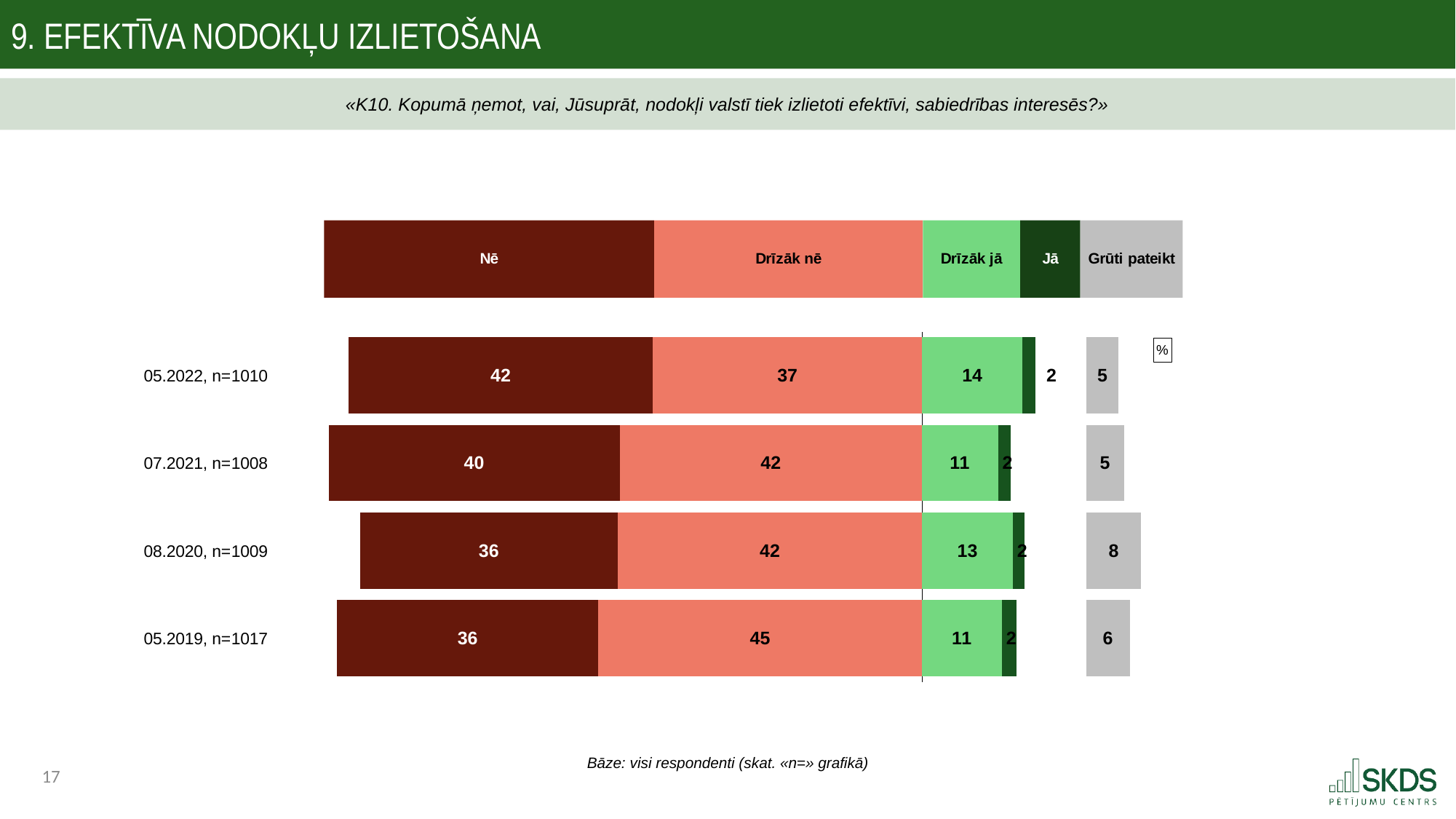
What is the value for "Drīzāk jā" in 07.2021? 11 In which survey wave is the "Drīzāk jā" value highest? 05.2022, n=1010 What is the value for "Grūti pateikt" in 08.2020? 8 What is the combined total of "Nē" and "Drīzāk nē" for 07.2021? 82 What percentage of respondents answered "Nē" in 05.2022? 42 In which survey wave is the "Nē" value highest? 05.2022, n=1010 What type of chart is shown on the slide? Stacked bar chart What is the difference between the "Nē" values for 05.2022 and 05.2019? 6 How many survey waves (rows) are shown in the chart? 4 What is the value for "Drīzāk nē" in 05.2019? 45 How many response categories does the legend list? 5 Which is larger in 08.2020: the "Nē" value or the "Drīzāk nē" value? Drīzāk nē